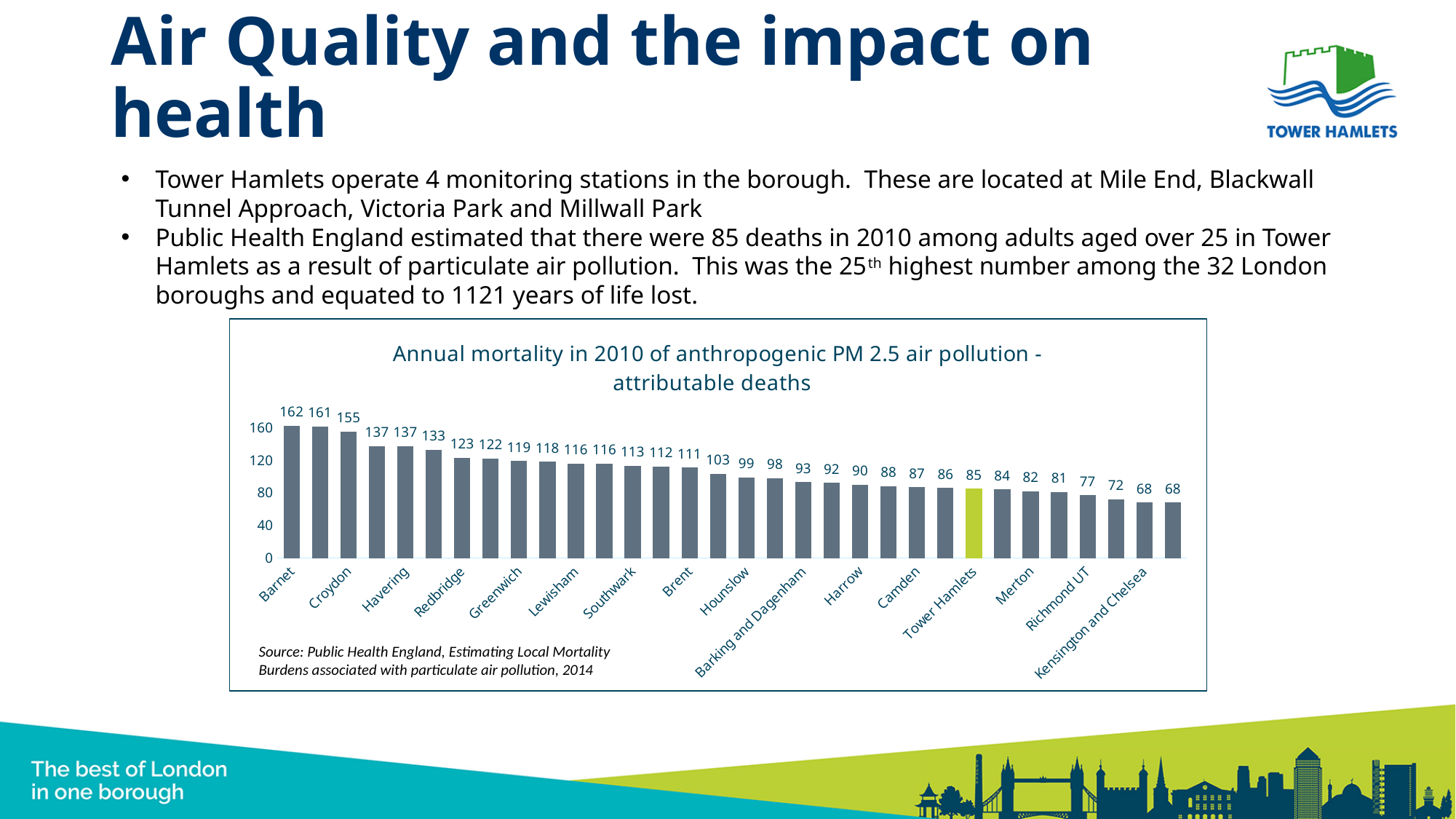
Which bar is highlighted in a different colour (green) from the others? Tower Hamlets How many bars are plotted in the chart? 32 Do the values rise or fall from left to right along the x axis? fall What type of chart is shown on the slide? bar chart Which has a higher value, Barnet or Tower Hamlets? Barnet What is the highest value shown in the chart? 162 How many attributable deaths are shown for Kensington and Chelsea? 68 What is the lowest value shown in the chart? 68 What is the difference between the values for Barnet and Tower Hamlets? 77 How many attributable deaths are shown for Tower Hamlets? 85 What is the title of the chart? Annual mortality in 2010 of anthropogenic PM 2.5 air pollution - attributable deaths How many attributable deaths are shown for Barnet? 162